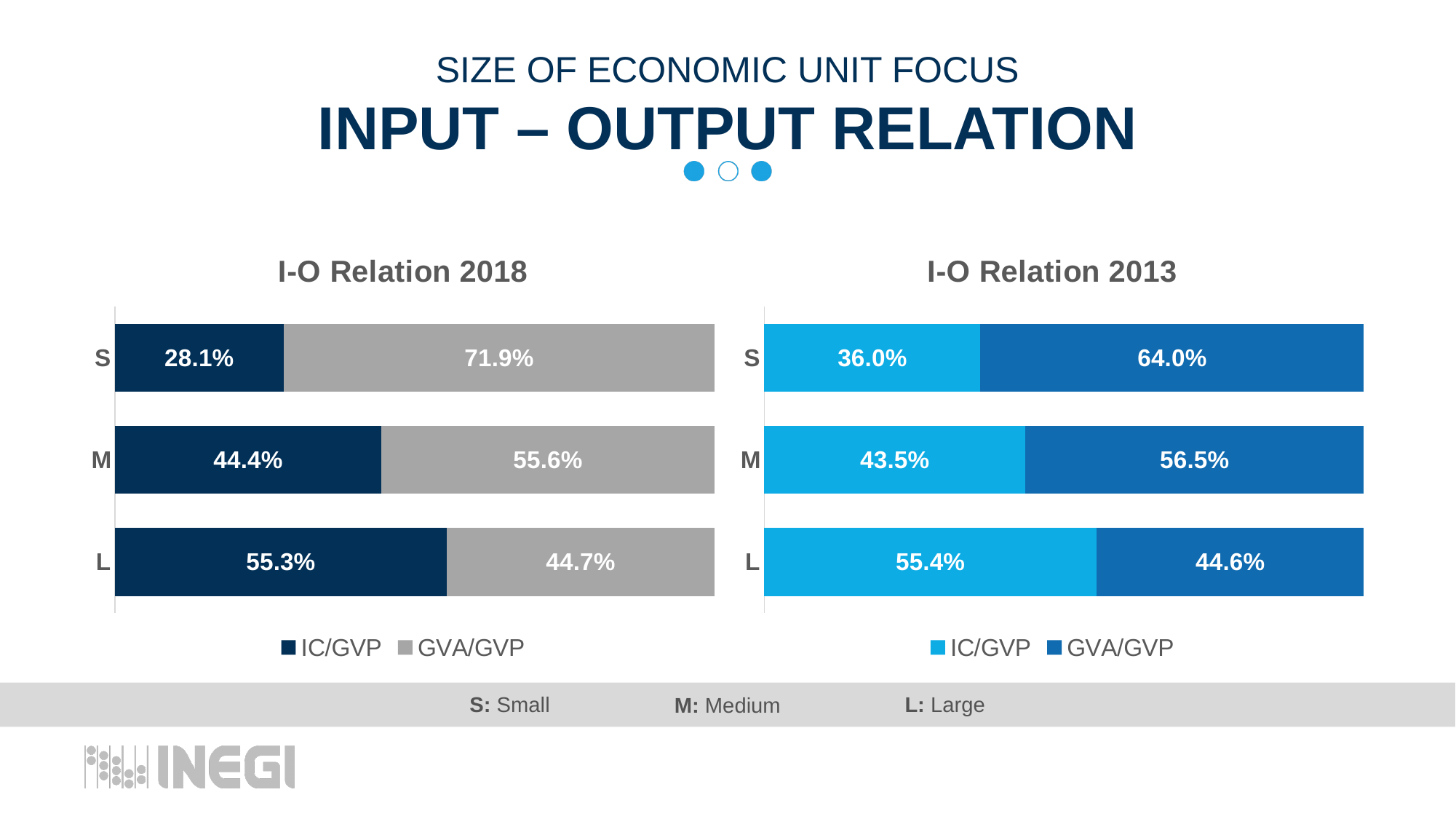
In the I-O Relation 2018 chart, how many categories are shown? 3 In the I-O Relation 2018 chart, which category has the highest IC/GVP value? L In the I-O Relation 2018 chart, what is the total of the stacked bar for M? 100.0% In the I-O Relation 2013 chart, what is the IC/GVP value for L? 55.4% In the I-O Relation 2018 chart, what is the IC/GVP value for S? 28.1% In the I-O Relation 2013 chart, what is the GVA/GVP value for M? 56.5% In the I-O Relation 2013 chart, how many series does the legend list? 2 In the I-O Relation 2018 chart, what is the GVA/GVP value for L? 44.7% In the I-O Relation 2013 chart, which category has the lowest IC/GVP value? S What type of chart is the I-O Relation 2018 chart? Stacked bar chart In the I-O Relation 2013 chart, which is larger for S: IC/GVP or GVA/GVP? GVA/GVP In the I-O Relation 2018 chart, what is the difference between the GVA/GVP values for S and M? 16.3%